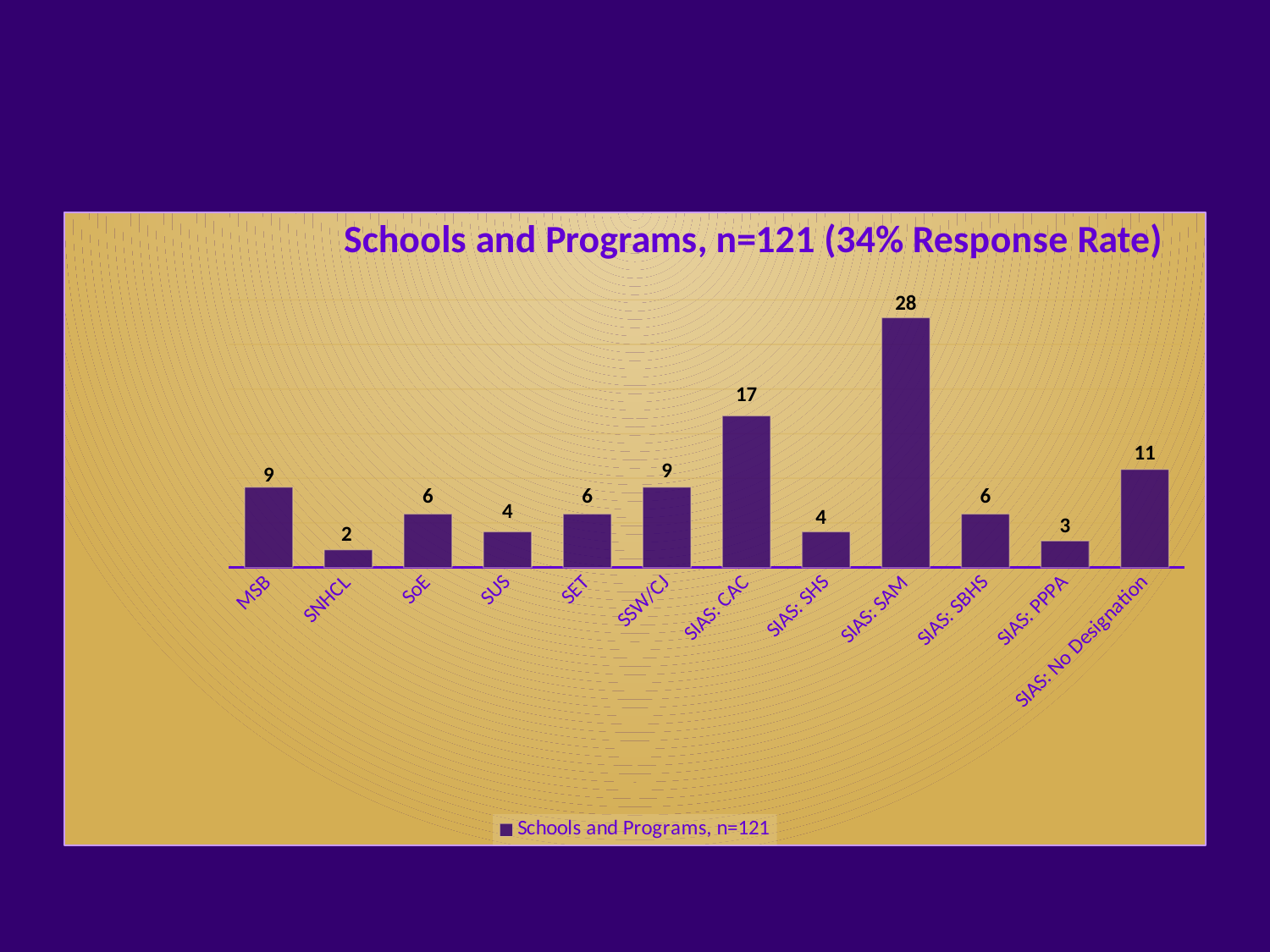
Which is larger, the value for MSB or the value for SIAS: PPPA? MSB What is the difference between the values for SIAS: SAM and SIAS: CAC? 11 What is the value for SIAS: No Designation? 11 What is the title of the chart? Schools and Programs, n=121 (34% Response Rate) What is the value for SIAS: SAM? 28 How many series does the legend list? 1 Which category has the highest value? SIAS: SAM What is the value for SNHCL? 2 What kind of chart is shown on the slide? Bar chart How many categories are shown on the x axis? 12 What is the difference between the values for SSW/CJ and SUS? 5 Which category has the lowest value? SNHCL